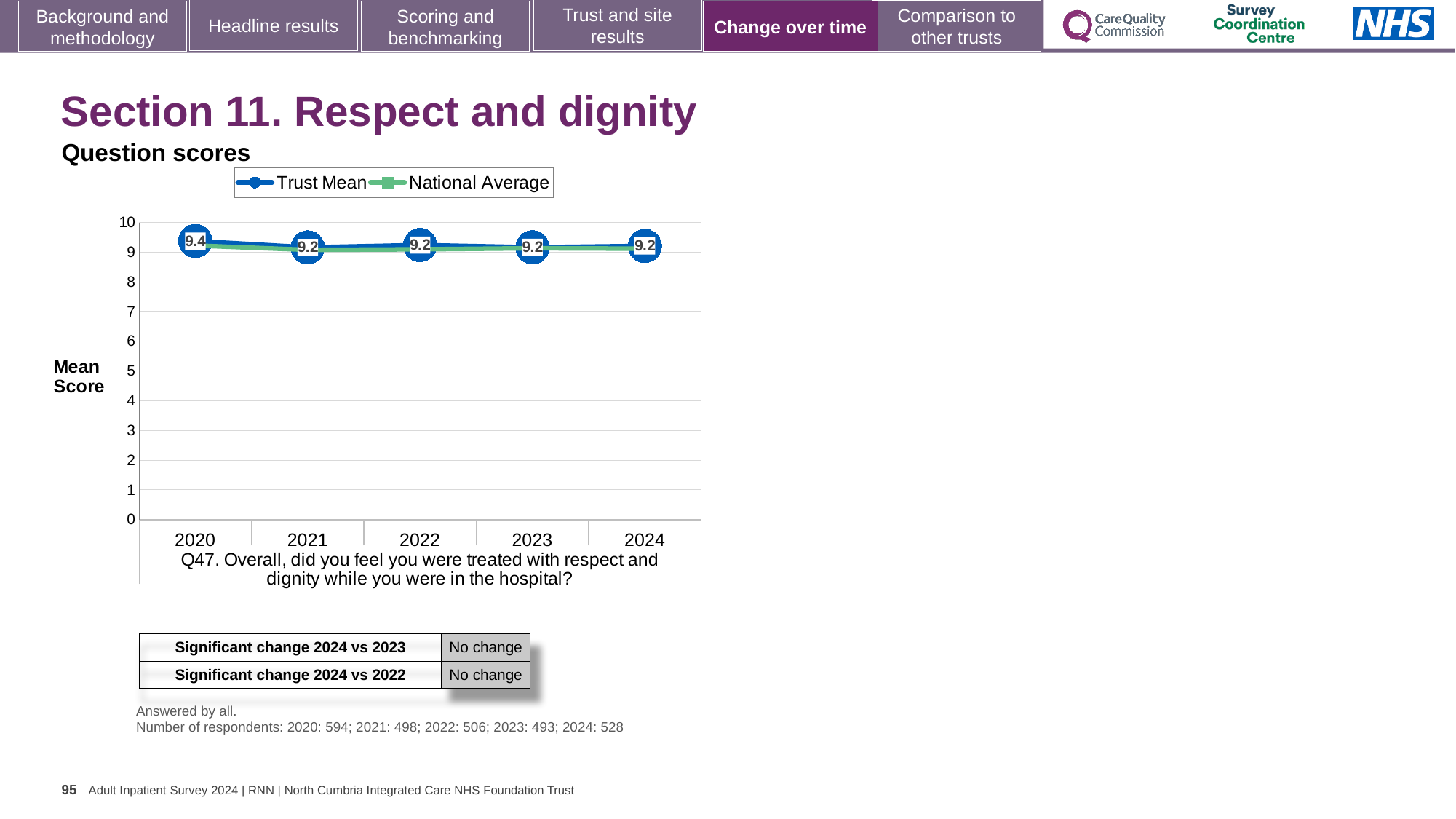
What is the Trust Mean score for 2024? 9.2 Does the Trust Mean score rise or fall from 2020 to 2021? Fall How many series does the legend list? 2 What is the label on the y axis of the chart? Mean Score Which is larger, the Trust Mean score for 2020 or for 2023? 2020 In which year is the Trust Mean score highest? 2020 What is the Trust Mean score for 2022? 9.2 How many years are plotted on the x axis? 5 Is the National Average value for 2020 greater or less than 8? greater What is the Trust Mean score for 2020? 9.4 What kind of chart is shown on the slide? Line chart What is the difference between the Trust Mean score in 2020 and in 2021? 0.2